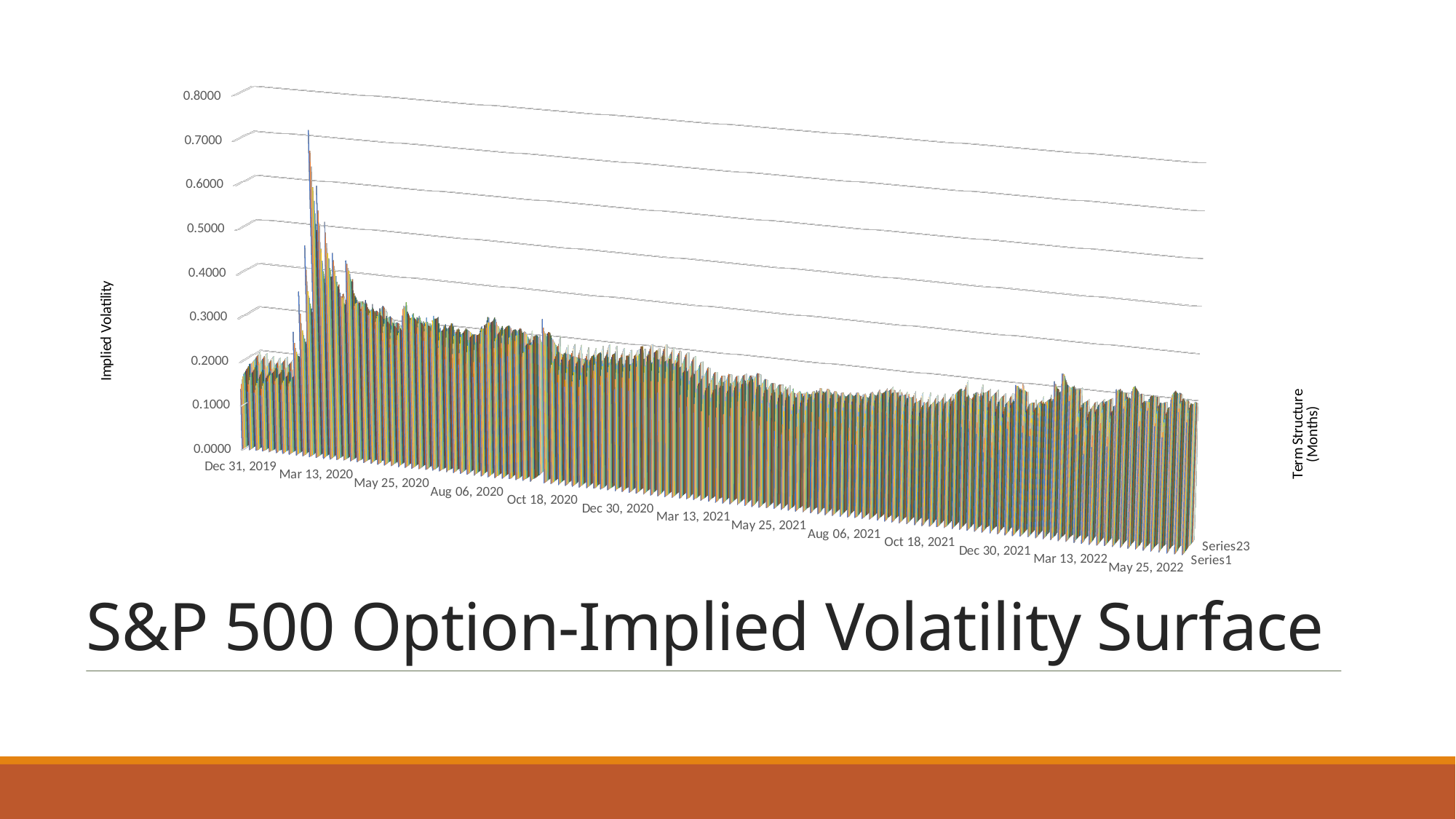
What is the title of the slide's chart? S&P 500 Option-Implied Volatility Surface How many date labels are shown along the horizontal axis? 13 What kind of chart is shown on the slide? 3D surface chart What is the first date label on the horizontal axis? Dec 31, 2019 After the spike in early 2020, do implied volatility values generally rise or fall along the date axis? fall What is the highest tick value shown on the vertical axis? 0.8000 Around which date label does implied volatility reach its highest point? Mar 13, 2020 What is the label on the vertical axis of the chart? Implied Volatility Is the implied volatility at Dec 31, 2019 greater or less than 0.3000? less Is the peak implied volatility near Mar 13, 2020 greater or less than 0.6000? greater What is the lowest tick value shown on the vertical axis? 0.0000 Is the implied volatility at May 25, 2022 greater or less than 0.3000? less